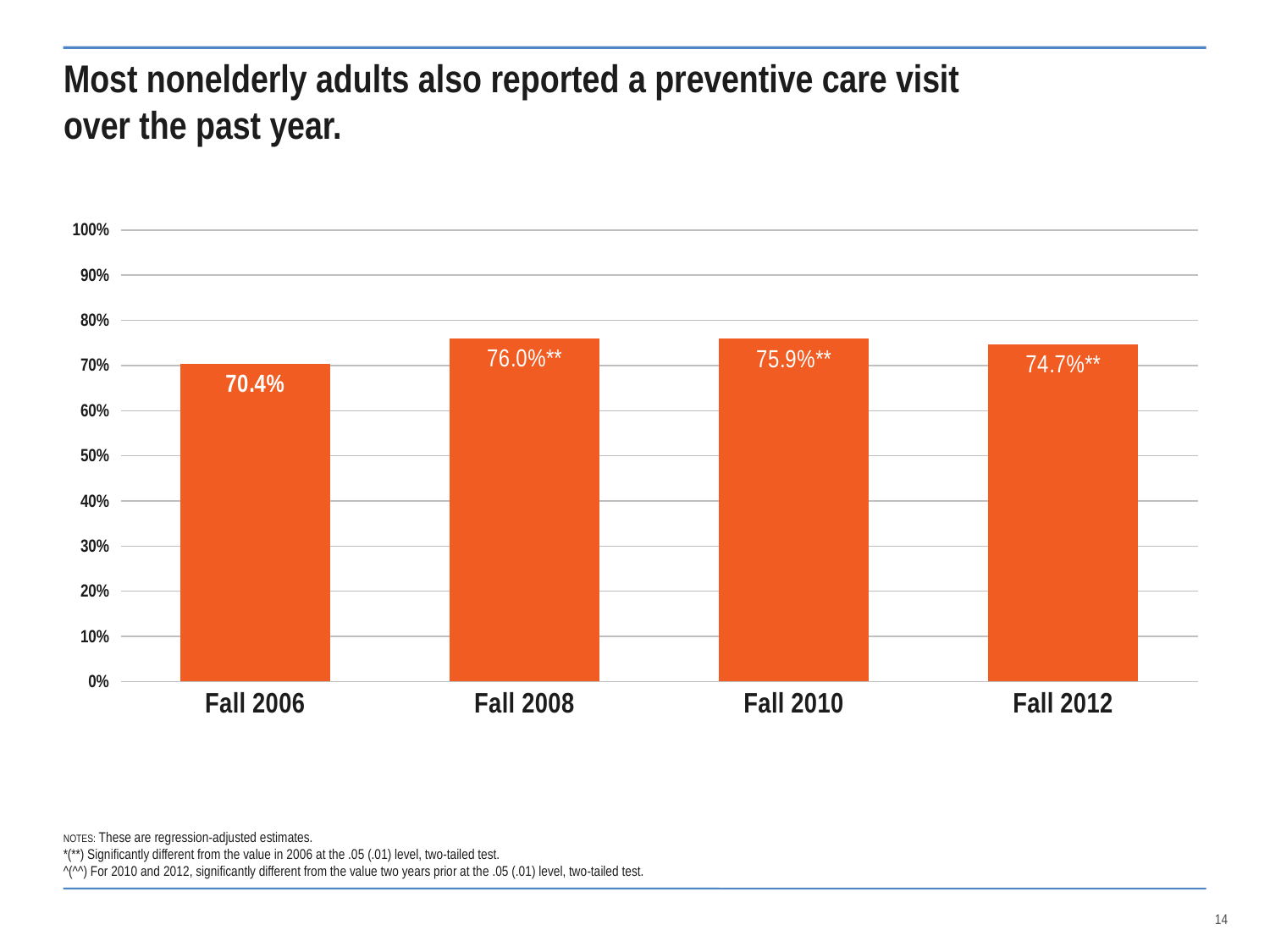
How many periods are shown on the x axis? 4 Is the value for Fall 2010 greater or less than 70%? greater Which period has the lowest value? Fall 2006 What value is shown for Fall 2006? 70.4% Which is larger, the value for Fall 2012 or the value for Fall 2006? Fall 2012 Which period has the highest value? Fall 2008 What is the highest value marked on the vertical axis? 100% What kind of chart is shown on the slide? Bar chart What is the difference between the Fall 2008 value and the Fall 2006 value? 5.6 percentage points What value is shown for Fall 2010? 75.9% What value is shown for Fall 2012? 74.7% What value is shown for Fall 2008? 76.0%